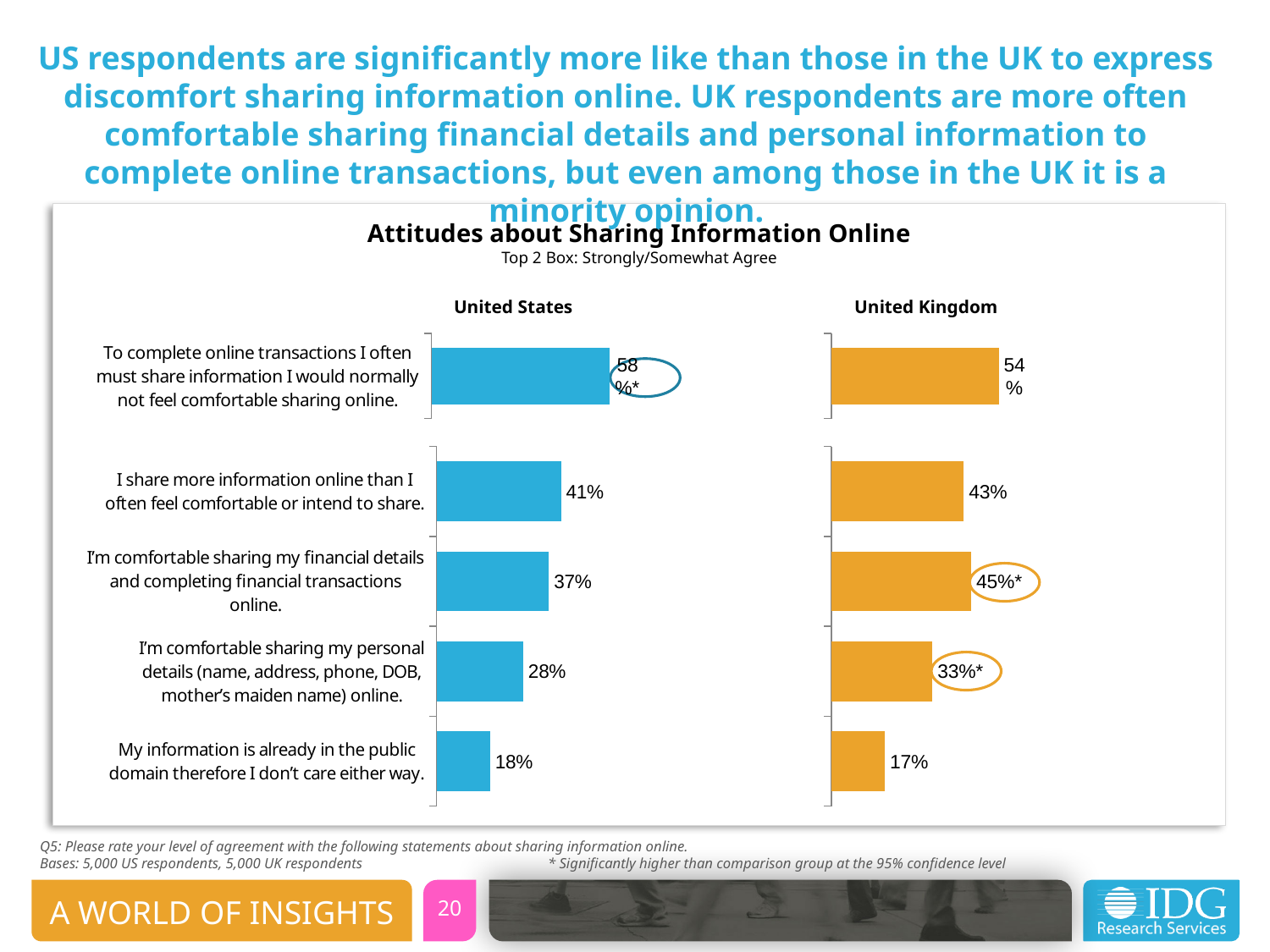
In the United States chart, what percentage agree with "I'm comfortable sharing my personal details (name, address, phone, DOB, mother's maiden name) online"? 28% In the United Kingdom chart, what is the difference between the top statement (54%) and "I share more information online than I often feel comfortable or intend to share" (43%)? 11 percentage points In the United Kingdom chart, what percentage agree with "My information is already in the public domain therefore I don't care either way"? 17% In the United States chart, what is the difference between agreement with "I share more information online than I often feel comfortable or intend to share" (41%) and "I'm comfortable sharing my personal details" (28%)? 13 percentage points What type of chart is used to show the attitudes about sharing information online? Bar chart In the United States chart, which statement has the highest level of agreement? To complete online transactions I often must share information I would normally not feel comfortable sharing online. For "I'm comfortable sharing my financial details and completing financial transactions online", which country shows higher agreement, the United States or the United Kingdom? United Kingdom How many statements are shown in each chart? 5 What is the subtitle shown under the chart title "Attitudes about Sharing Information Online"? Top 2 Box: Strongly/Somewhat Agree In the United Kingdom chart, which statement has the lowest level of agreement? My information is already in the public domain therefore I don't care either way. In the United Kingdom chart, what percentage agree with "I'm comfortable sharing my financial details and completing financial transactions online"? 45% In the United States chart, what percentage agree with "I share more information online than I often feel comfortable or intend to share"? 41%